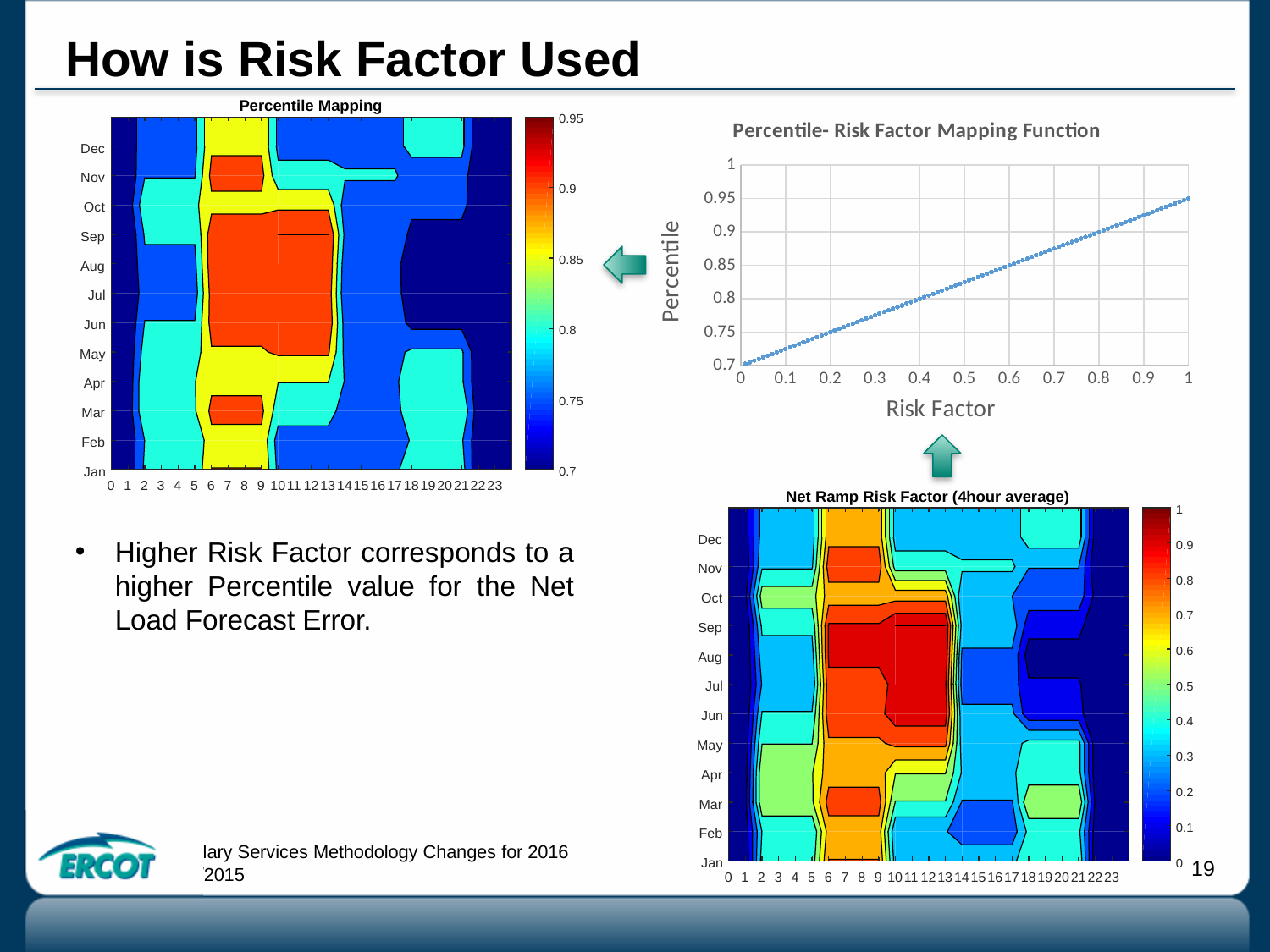
How many months are shown on the vertical axis of the 'Net Ramp Risk Factor (4hour average)' chart? 12 What kind of chart is the 'Percentile- Risk Factor Mapping Function' chart? scatter chart What is the title of the vertical axis of the 'Percentile- Risk Factor Mapping Function' chart? Percentile In the 'Percentile- Risk Factor Mapping Function' chart, which is larger: the Percentile at a Risk Factor of 0.3 or at a Risk Factor of 0.7? 0.7 What is the highest value shown on the colour bar of the 'Net Ramp Risk Factor (4hour average)' chart? 1 How many hour ticks (0 to 23) are shown on the horizontal axis of the 'Percentile Mapping' chart? 24 In the 'Percentile- Risk Factor Mapping Function' chart, do the Percentile values rise or fall as Risk Factor increases? rise In the 'Percentile- Risk Factor Mapping Function' chart, what is the Percentile value at a Risk Factor of 1? 0.95 In the 'Percentile- Risk Factor Mapping Function' chart, is the Percentile value at a Risk Factor of 0.2 greater or less than 0.8? less In the 'Percentile- Risk Factor Mapping Function' chart, is the Percentile value at a Risk Factor of 0.8 greater or less than 0.85? greater In the 'Percentile- Risk Factor Mapping Function' chart, what is the Percentile value at a Risk Factor of 0? 0.7 In the 'Percentile- Risk Factor Mapping Function' chart, is the Percentile value at a Risk Factor of 0.5 greater or less than 0.9? less